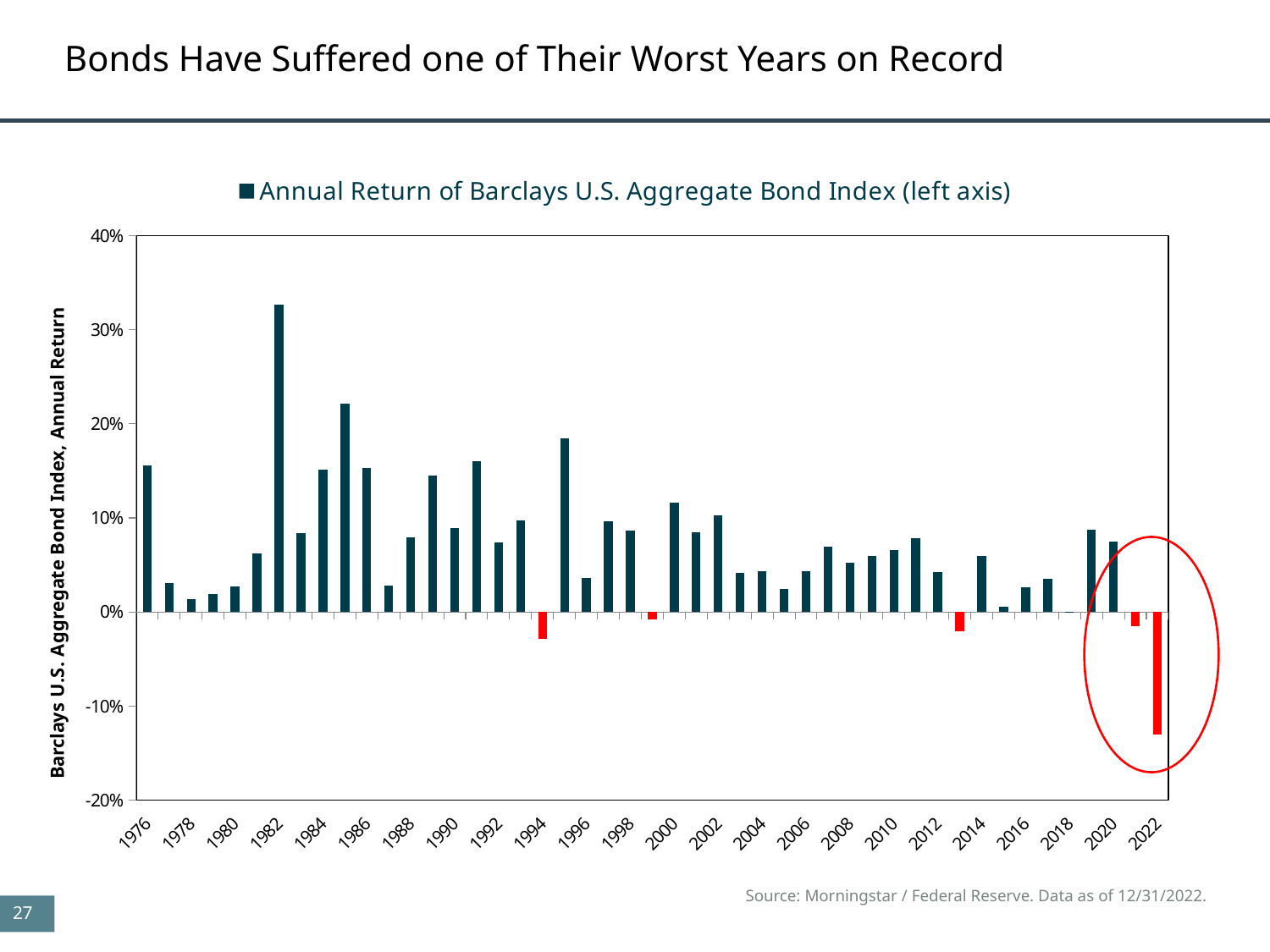
Which year has the larger annual return, 1982 or 1986? 1982 Is the value for 1994 greater or less than 0%? less Is the value for 1976 greater or less than 10%? greater Is the value for 2022 greater or less than -10%? less What is the legend entry for the series shown in the chart? Annual Return of Barclays U.S. Aggregate Bond Index (left axis) What kind of chart is shown on the slide? bar chart Which year has the lowest annual return? 2022 Which year has the highest annual return? 1982 How many series does the legend list? 1 Which year has the larger annual return, 1976 or 1978? 1976